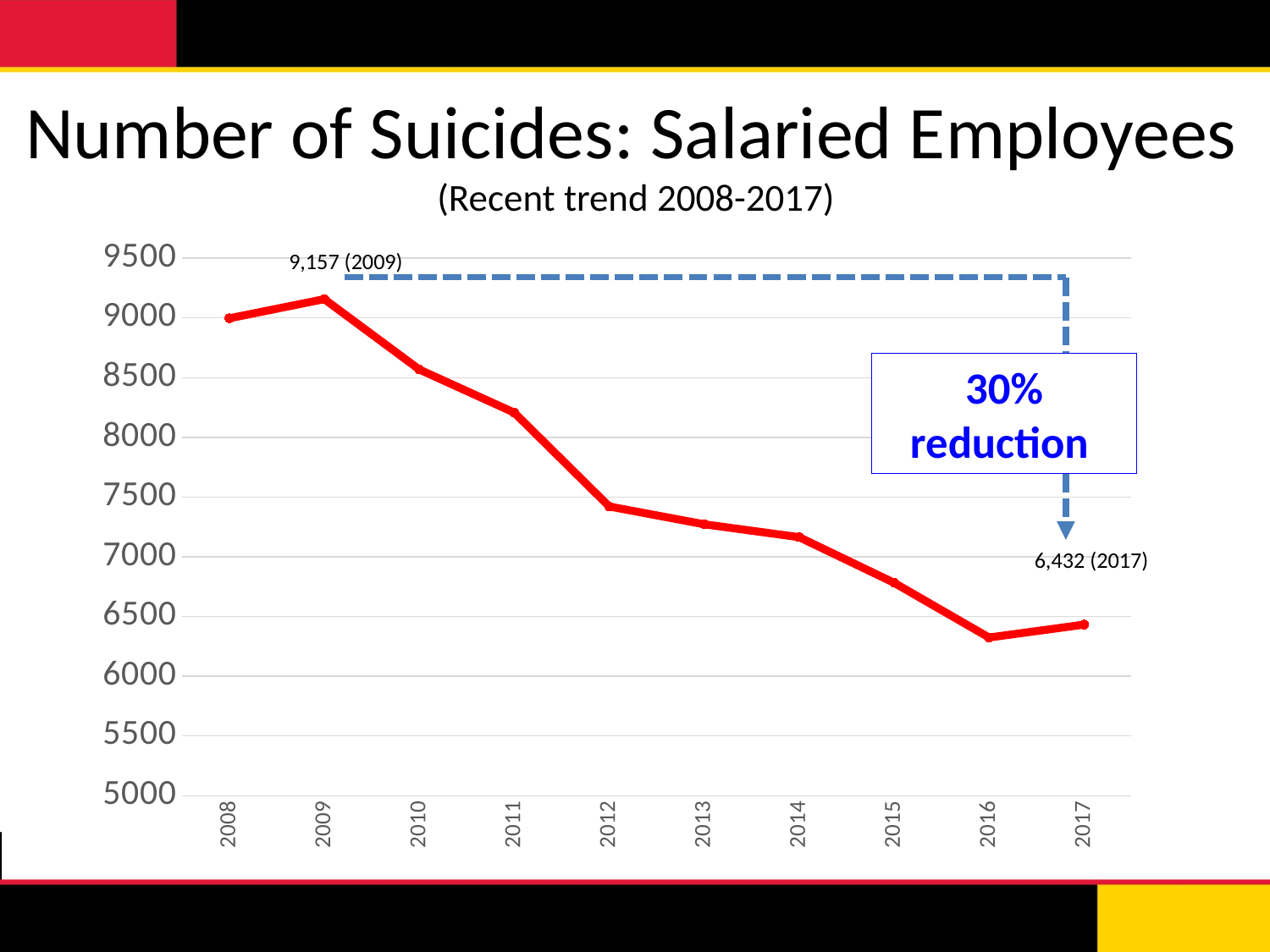
What is the number of suicides among salaried employees in 2017? 6,432 What is the difference between the 2009 value and the 2017 value? 2,725 Is the value for 2008 greater or less than 8500? greater Is the value for 2015 greater or less than 7000? less Do the values generally rise or fall from 2008 to 2017? fall What percentage reduction does the annotation on the chart state? 30% What is the number of suicides among salaried employees in 2009? 9,157 What kind of chart is shown on the slide? line chart Is the value for 2010 greater or less than 9000? less How many years are plotted on the chart? 10 Which year has the highest number of suicides? 2009 Which year has the lowest number of suicides? 2016